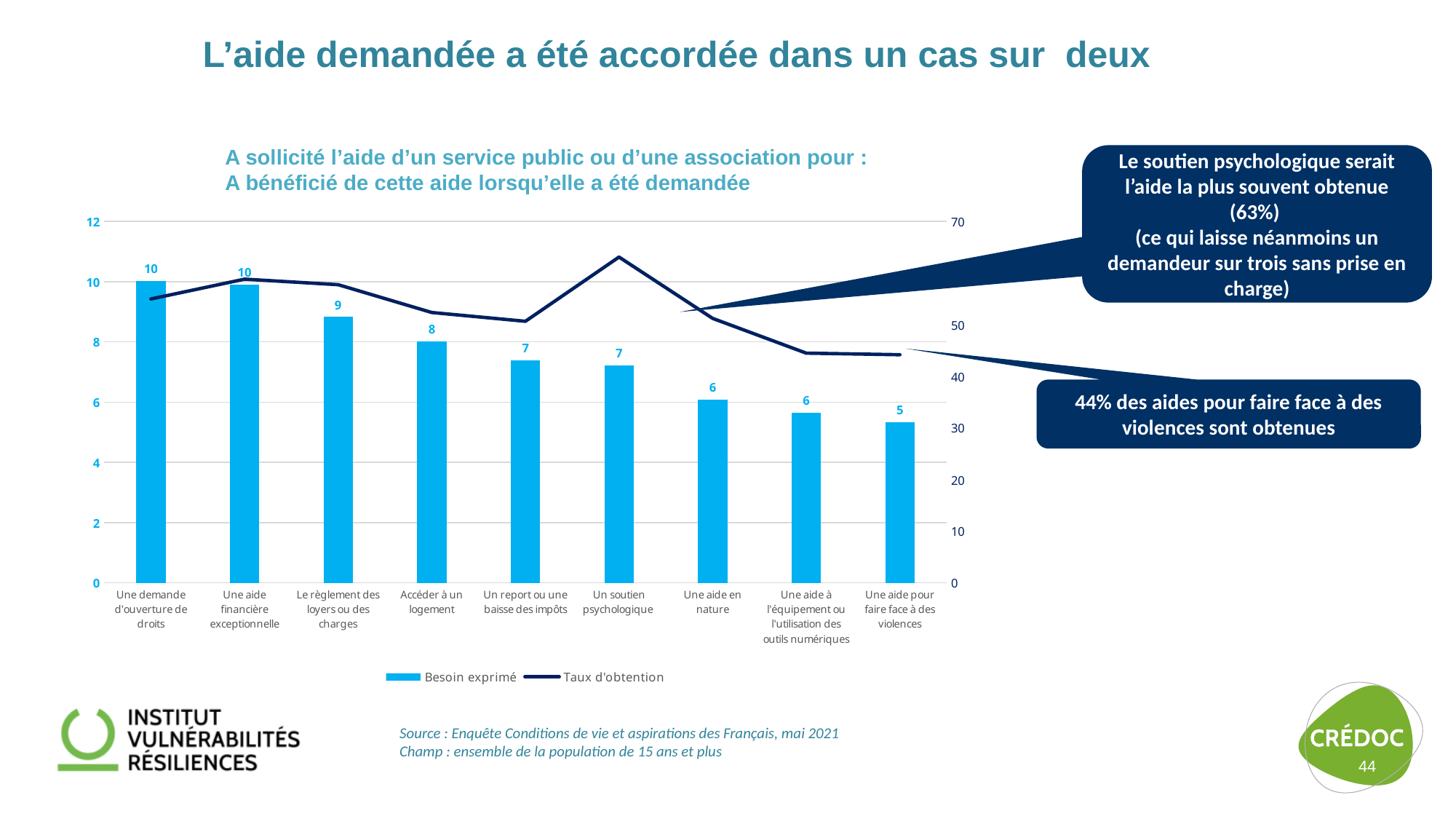
What kind of chart is shown on the slide? Combined bar and line chart Which category has the lowest 'Besoin exprimé' bar? Une aide pour faire face à des violences How many series does the chart legend list? 2 Do the 'Besoin exprimé' bars rise or fall from left to right along the x axis? fall What is the value of 'Besoin exprimé' for 'Une demande d'ouverture de droits'? 10 Which has a larger 'Besoin exprimé' value: 'Le règlement des loyers ou des charges' or 'Un report ou une baisse des impôts'? Le règlement des loyers ou des charges What is the difference between the 'Besoin exprimé' values for 'Une demande d'ouverture de droits' and 'Une aide pour faire face à des violences'? 5 What is the value of 'Besoin exprimé' for 'Une aide pour faire face à des violences'? 5 Is the 'Taux d'obtention' value for 'Un soutien psychologique' greater or less than 50? greater What is the value of 'Besoin exprimé' for 'Accéder à un logement'? 8 Is the 'Taux d'obtention' value for 'Une aide pour faire face à des violences' greater or less than 50? less How many categories are shown on the x axis of the chart? 9